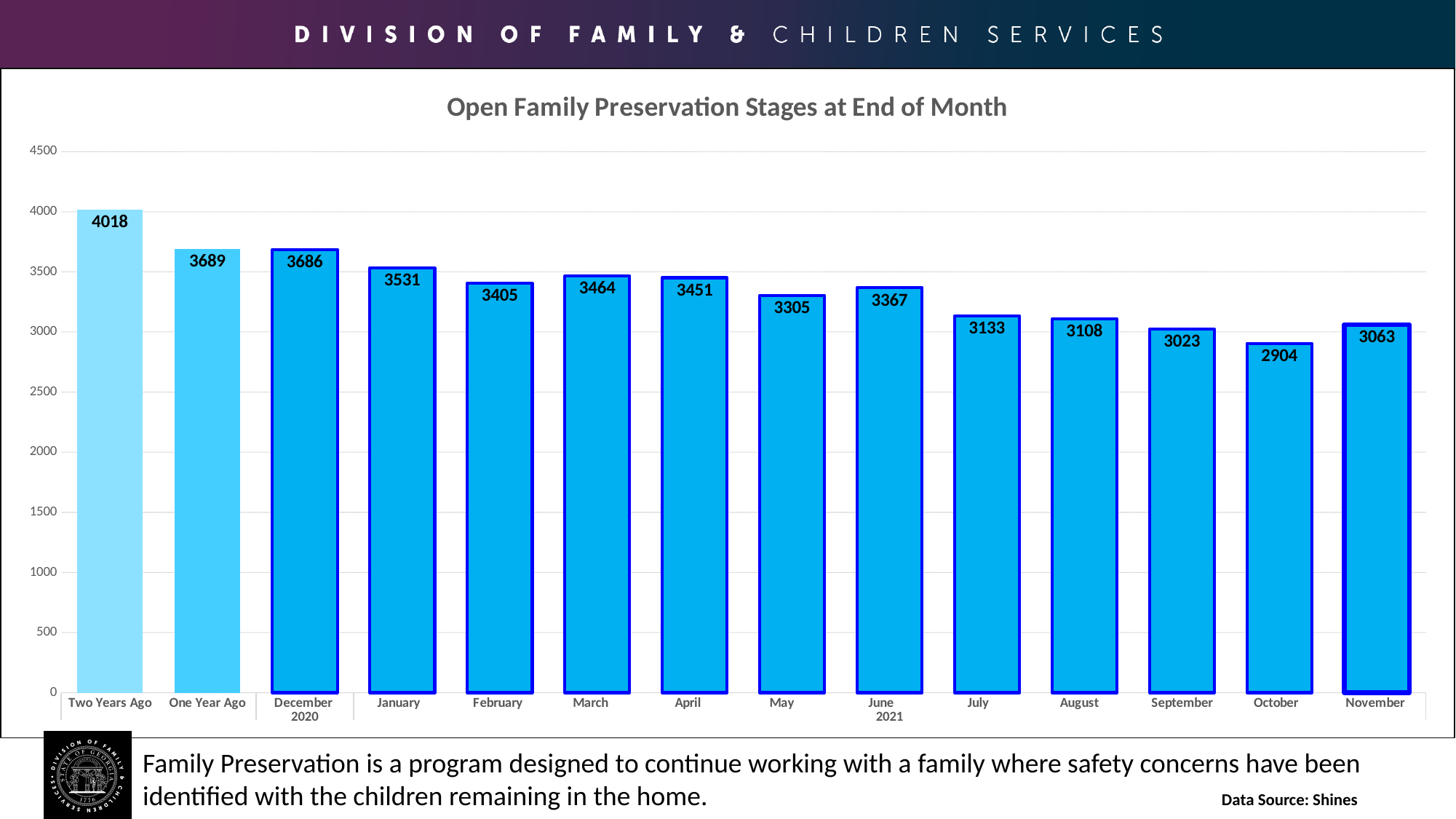
Which is larger, the value for June or the value for May? June What is the difference between the values for December 2020 and January? 155 What kind of chart is shown on the slide? Bar chart What is the difference between the values for One Year Ago and November? 626 What is the value for Two Years Ago? 4018 Is the value for September greater or less than 3000? greater How many bars are shown in the chart? 14 What is the value for October? 2904 What is the title of the chart? Open Family Preservation Stages at End of Month What is the value for March in the Open Family Preservation Stages at End of Month chart? 3464 Which category has the highest value? Two Years Ago Which category has the lowest value? October